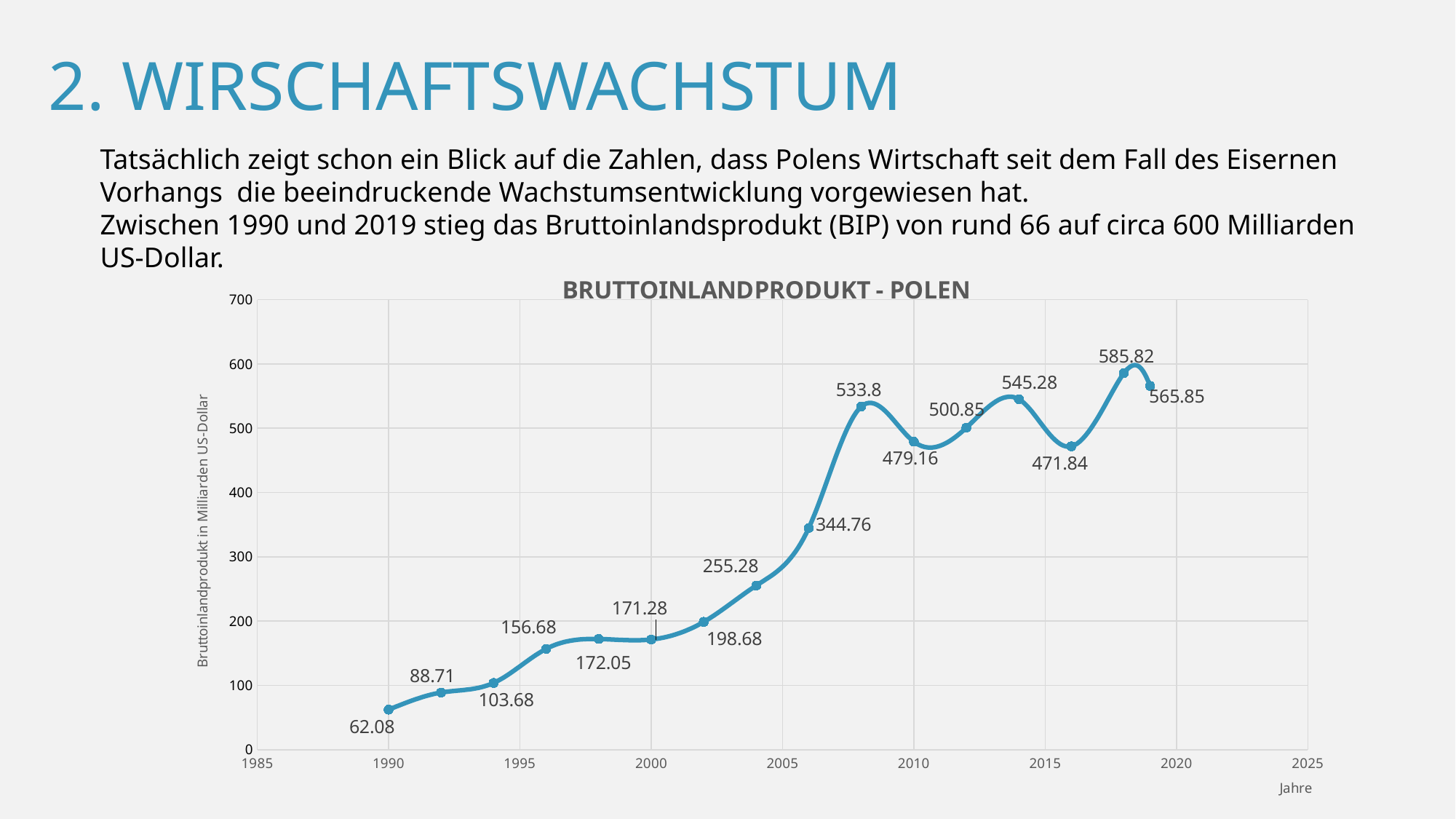
What type of chart is shown on the slide? Line chart What is the value plotted for 1990? 62.08 How many data points are plotted on the chart? 16 Which year has the highest value on the chart? 2018 What is the difference between the values for 2008 and 2006? 189.04 What is the difference between the values for 2019 and 1990? 503.77 Which year has the lowest value on the chart? 1990 What is the value plotted for 2019? 565.85 Which year has the larger value, 2010 or 2012? 2012 Is the value for 2016 greater or less than 500? less What is the title of the chart? BRUTTOINLANDPRODUKT - POLEN What is the value plotted for 2008? 533.8